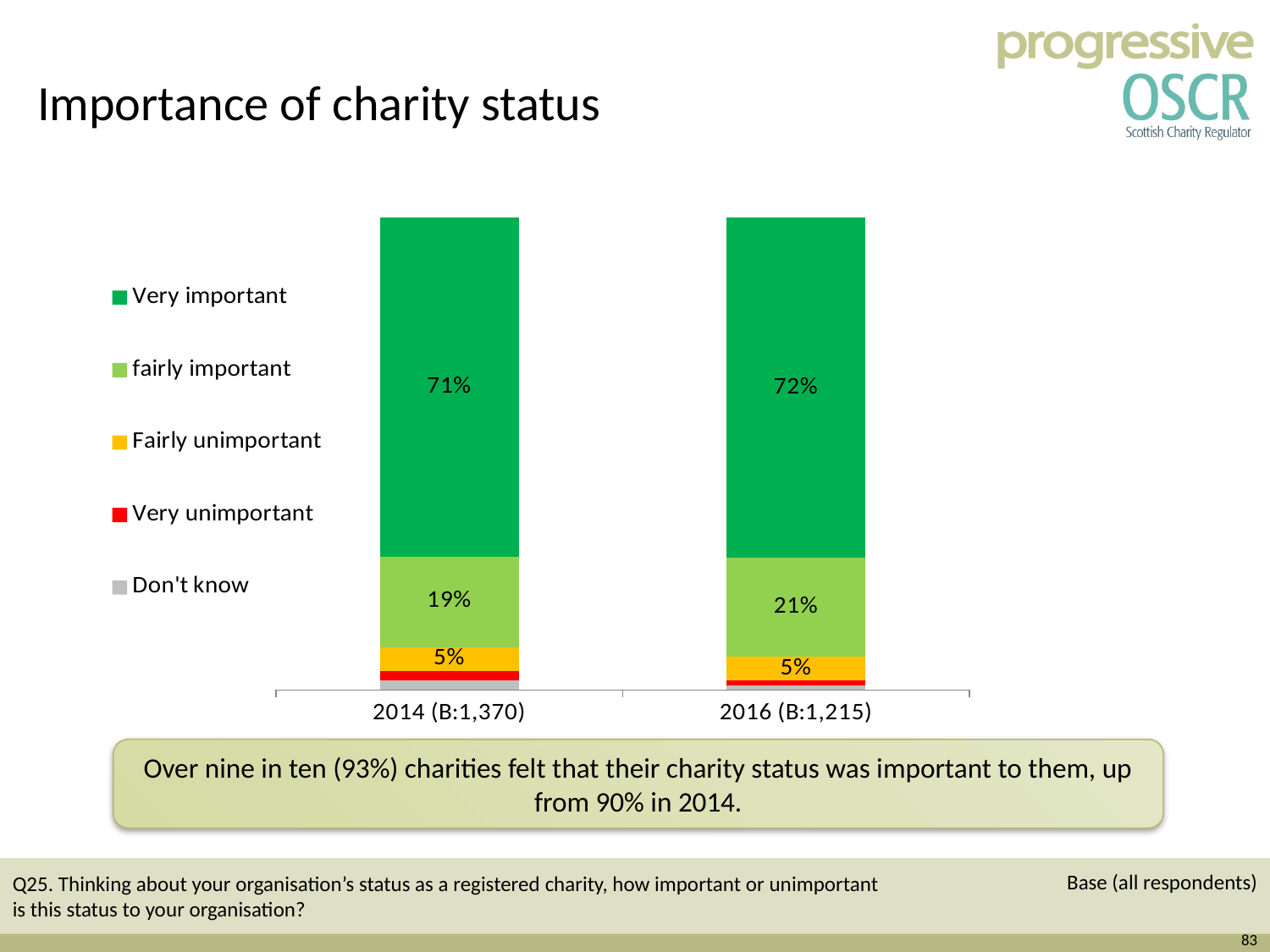
What is the 'fairly important' value for 2016 (B:1,215)? 21% What percentage of charities said charity status was 'Very important' in 2014 (B:1,370)? 71% What is the 'fairly important' value for 2014 (B:1,370)? 19% What type of chart is shown on the slide? Stacked bar chart What percentage of charities said charity status was 'Very important' in 2016 (B:1,215)? 72% What colour represents 'Very unimportant' in the legend? Red How many bars are plotted in the chart? 2 What is the 'Fairly unimportant' value for 2014 (B:1,370)? 5% Which year has the higher 'Very important' share, 2014 or 2016? 2016 By how many percentage points did the 'fairly important' share change from 2014 to 2016? 2 percentage points Which response category is the largest segment in the 2016 (B:1,215) bar? Very important How many series does the legend list? 5